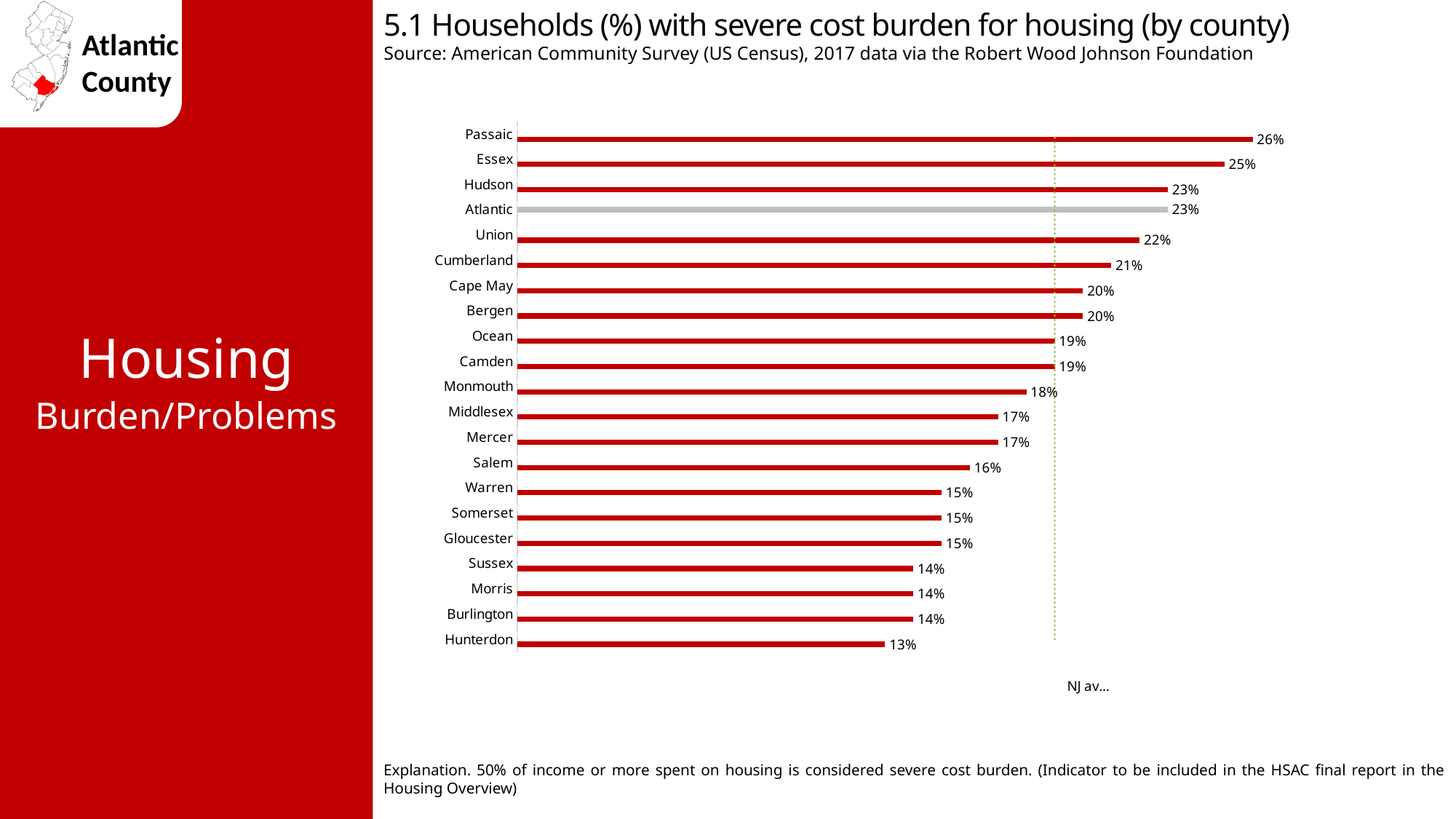
What is the value for Atlantic county? 23% What kind of chart is shown on the slide? Bar chart What is the difference between the values for Essex and Atlantic? 2% Which county's bar is shown in grey rather than red? Atlantic Which county has the lowest percentage of households with severe housing cost burden? Hunterdon Which has a higher value, Cape May or Sussex? Cape May What is the value for Hunterdon county? 13% Which has a higher value, Union or Salem? Union How many counties are shown in the chart? 21 What is the difference between the values for Passaic and Hunterdon? 13% Which county has the highest percentage of households with severe housing cost burden? Passaic What is the value for Cumberland county? 21%